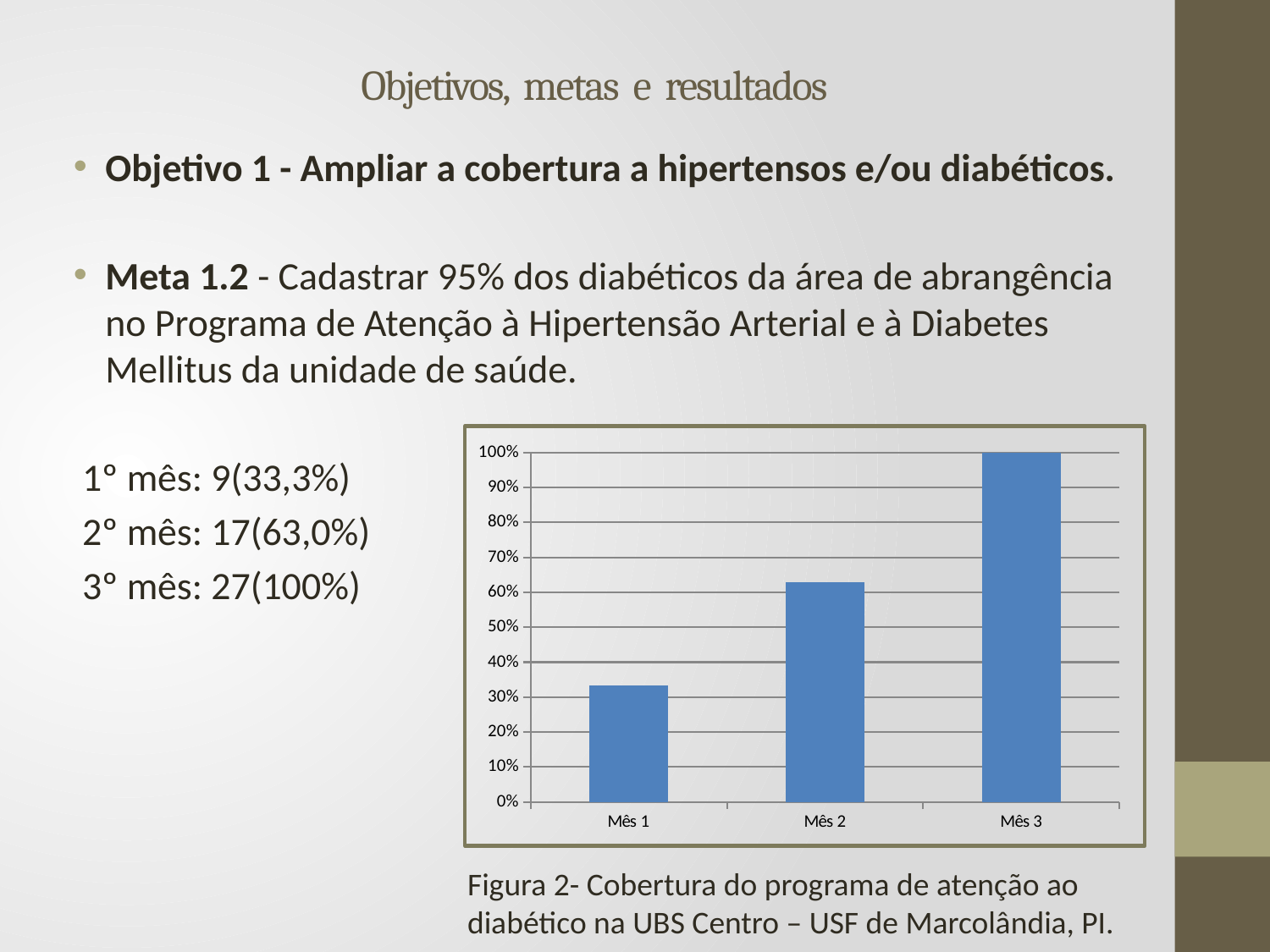
What kind of chart is shown on the slide? bar chart What is the value for Mês 3 in the chart? 100% How many categories (months) are plotted on the x axis of the chart? 3 Is the value for Mês 2 greater or less than 50%? greater Is the value for Mês 1 greater or less than 40%? less Which month has the lowest bar in the chart? Mês 1 Do the values rise or fall from Mês 1 to Mês 3? rise What is the figure caption given below the chart? Figura 2- Cobertura do programa de atenção ao diabético na UBS Centro – USF de Marcolândia, PI. Is the value for Mês 1 greater or less than 20%? greater Which month has the highest bar in the chart? Mês 3 What colour are the bars in the chart? blue Which is larger, the value for Mês 1 or the value for Mês 2? Mês 2